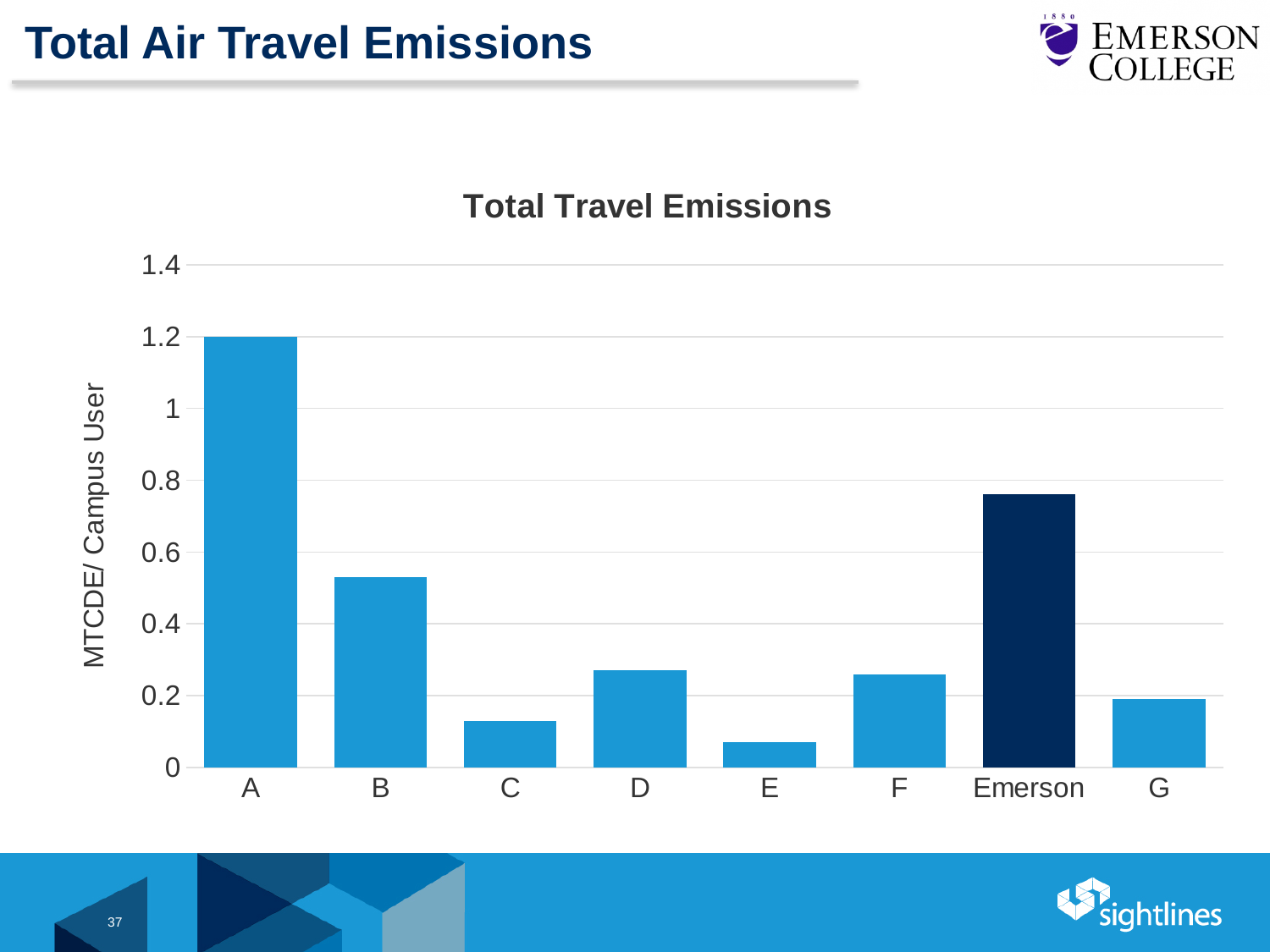
What kind of chart is shown on the slide? bar chart Which has higher total travel emissions, Emerson or B? Emerson Is the value for E greater or less than 0.2? less Which category has the highest total travel emissions? A Is the value for B greater or less than 0.4? greater Which has higher total travel emissions, C or G? G How many categories are shown on the x axis of the Total Travel Emissions chart? 8 Is the value for A greater or less than 1? greater What is the title of the chart? Total Travel Emissions Which category has the lowest total travel emissions? E What is the label on the y axis of the chart? MTCDE/ Campus User